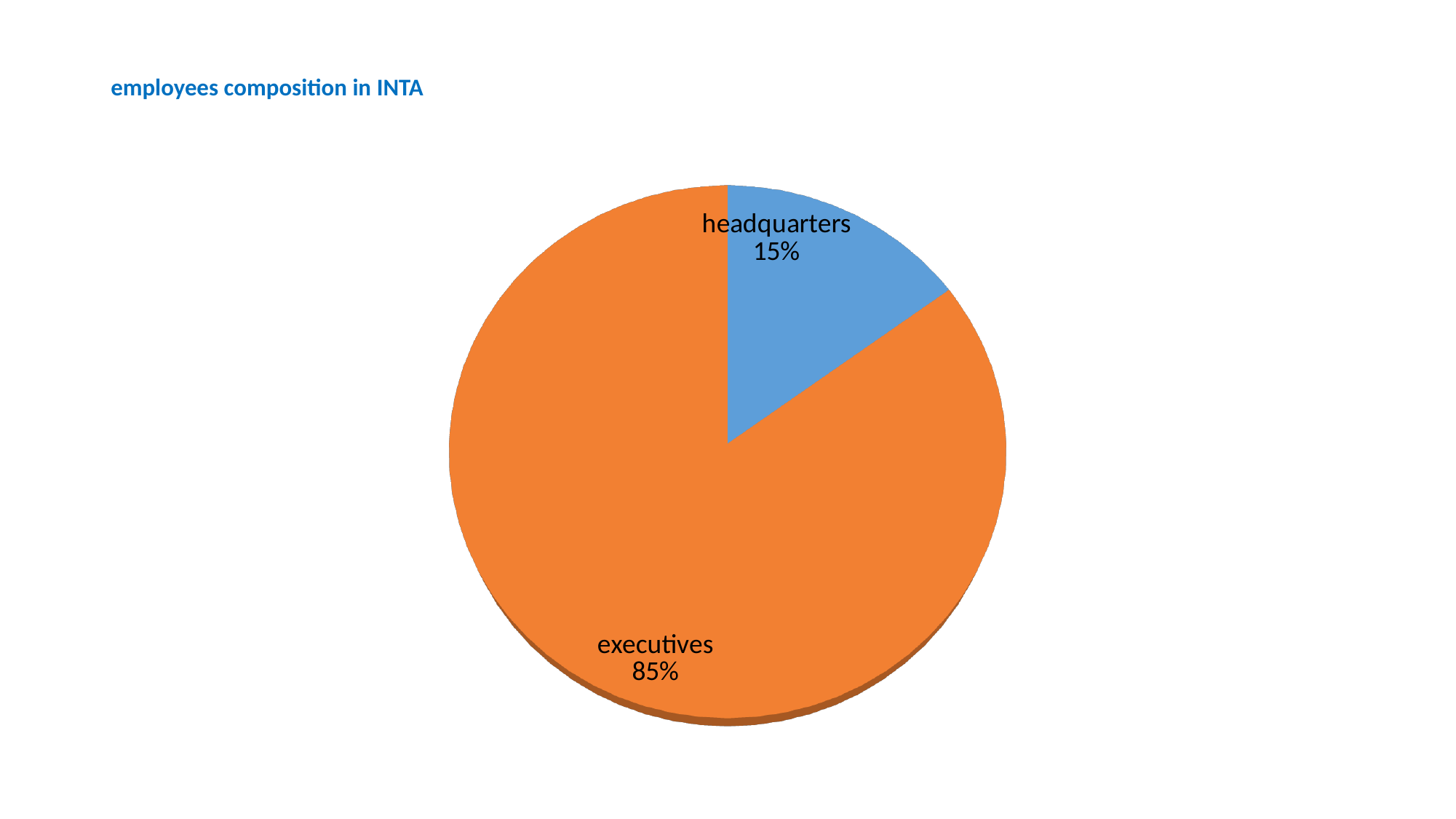
What kind of chart is shown on the slide? pie chart What is the title of the chart? employees composition in INTA What share of the pie does the executives slice represent? 85% What is the difference in percentage points between the executives and headquarters slices? 70 What colour is the headquarters slice? blue Which category has the smallest slice of the pie? headquarters How many slices does the pie chart have? 2 Which is larger, the executives slice or the headquarters slice? executives What share of the pie does the headquarters slice represent? 15% Which category has the largest slice of the pie? executives